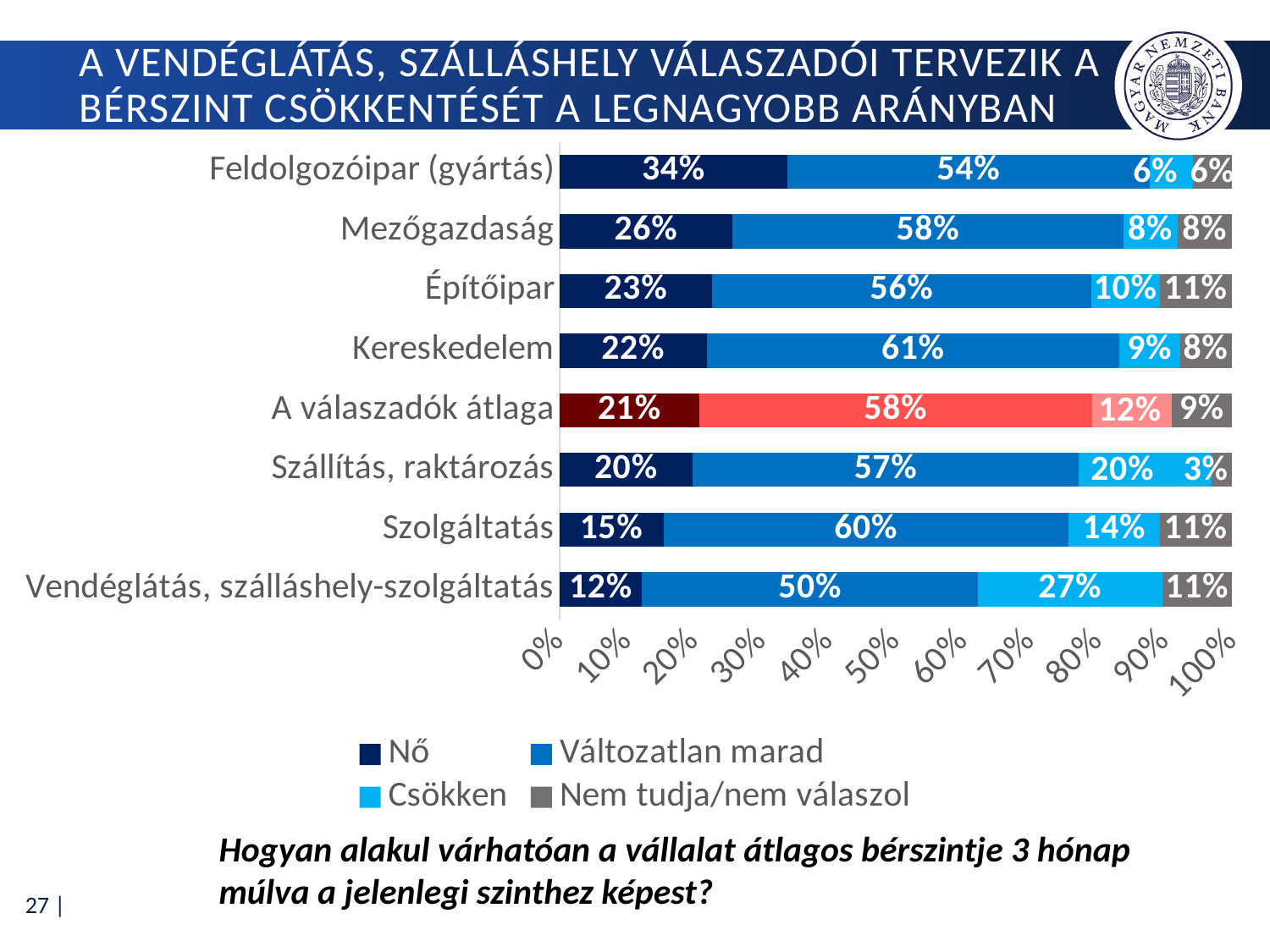
How many series does the legend list? 4 Which is larger: the "Változatlan marad" value for Szolgáltatás or for Építőipar? Szolgáltatás What is the value of the "Nem tudja/nem válaszol" series for Szállítás, raktározás? 3% What is the value of the "Nő" series for Feldolgozóipar (gyártás)? 34% What is the value of the "Csökken" series for Vendéglátás, szálláshely-szolgáltatás? 27% Which category has the highest value for the "Csökken" series? Vendéglátás, szálláshely-szolgáltatás Which category's bar is drawn in red shades instead of blue? A válaszadók átlaga How many categories are shown on the chart? 8 What is the difference between the "Nő" values for Feldolgozóipar (gyártás) and Mezőgazdaság? 8% What is the value of the "Változatlan marad" series for Kereskedelem? 61% What kind of chart is shown on the slide? Stacked bar chart Which category has the lowest value for the "Nő" series? Vendéglátás, szálláshely-szolgáltatás